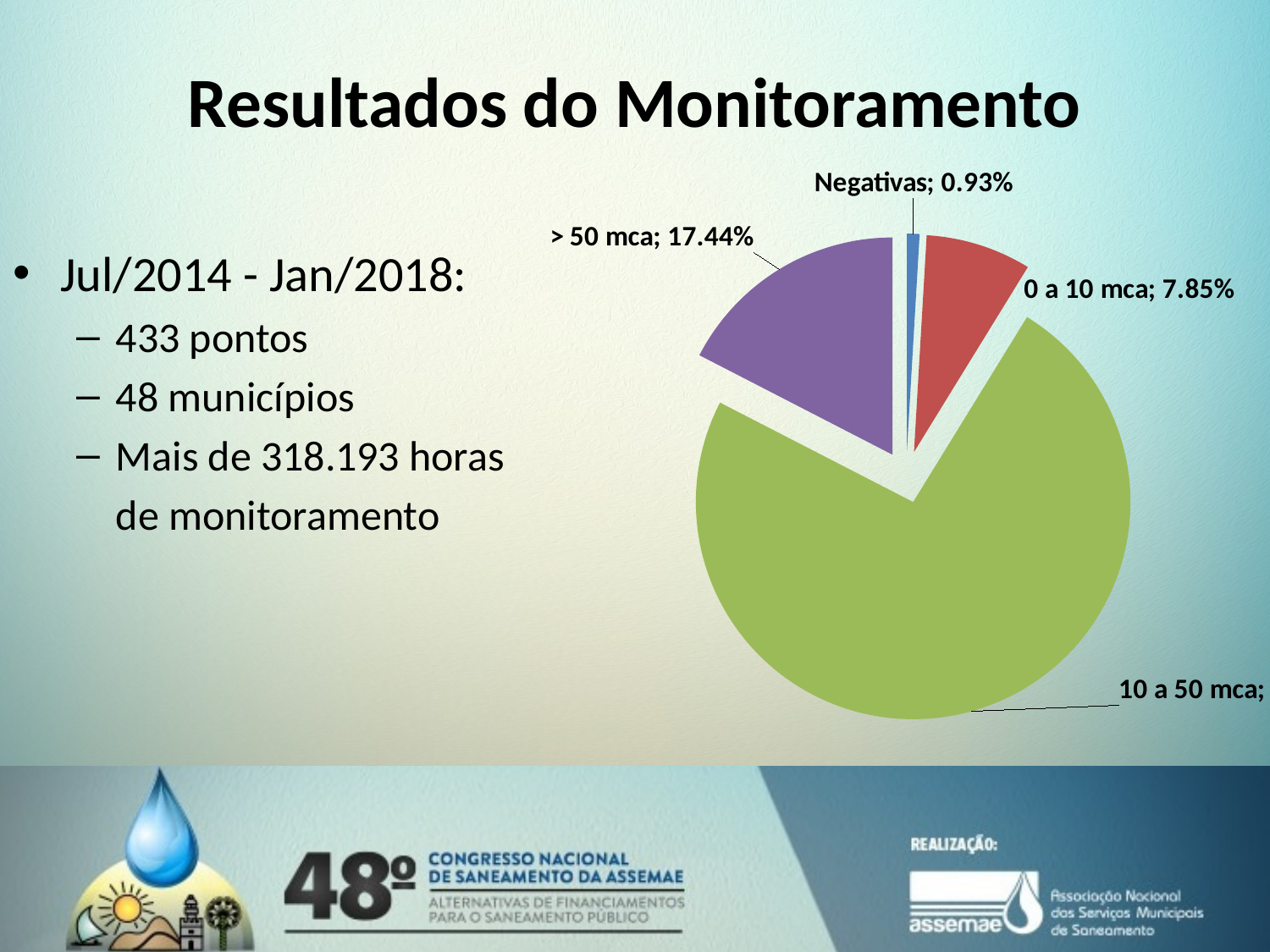
What percentage is shown for the 0 a 10 mca slice? 7.85% What percentage is shown for the Negativas slice? 0.93% What percentage is shown for the > 50 mca slice? 17.44% What is the difference between the 0 a 10 mca share and the Negativas share? 6.92% How many slices does the pie chart have? 4 Which category is shown by the purple slice? > 50 mca What kind of chart is shown on the slide? pie chart Which slice of the pie chart is the smallest? Negativas What is the difference between the > 50 mca share and the 0 a 10 mca share? 9.59% Which is larger, the > 50 mca slice or the 0 a 10 mca slice? > 50 mca Which slice of the pie chart is the largest? 10 a 50 mca What colour is the largest slice of the pie chart? green